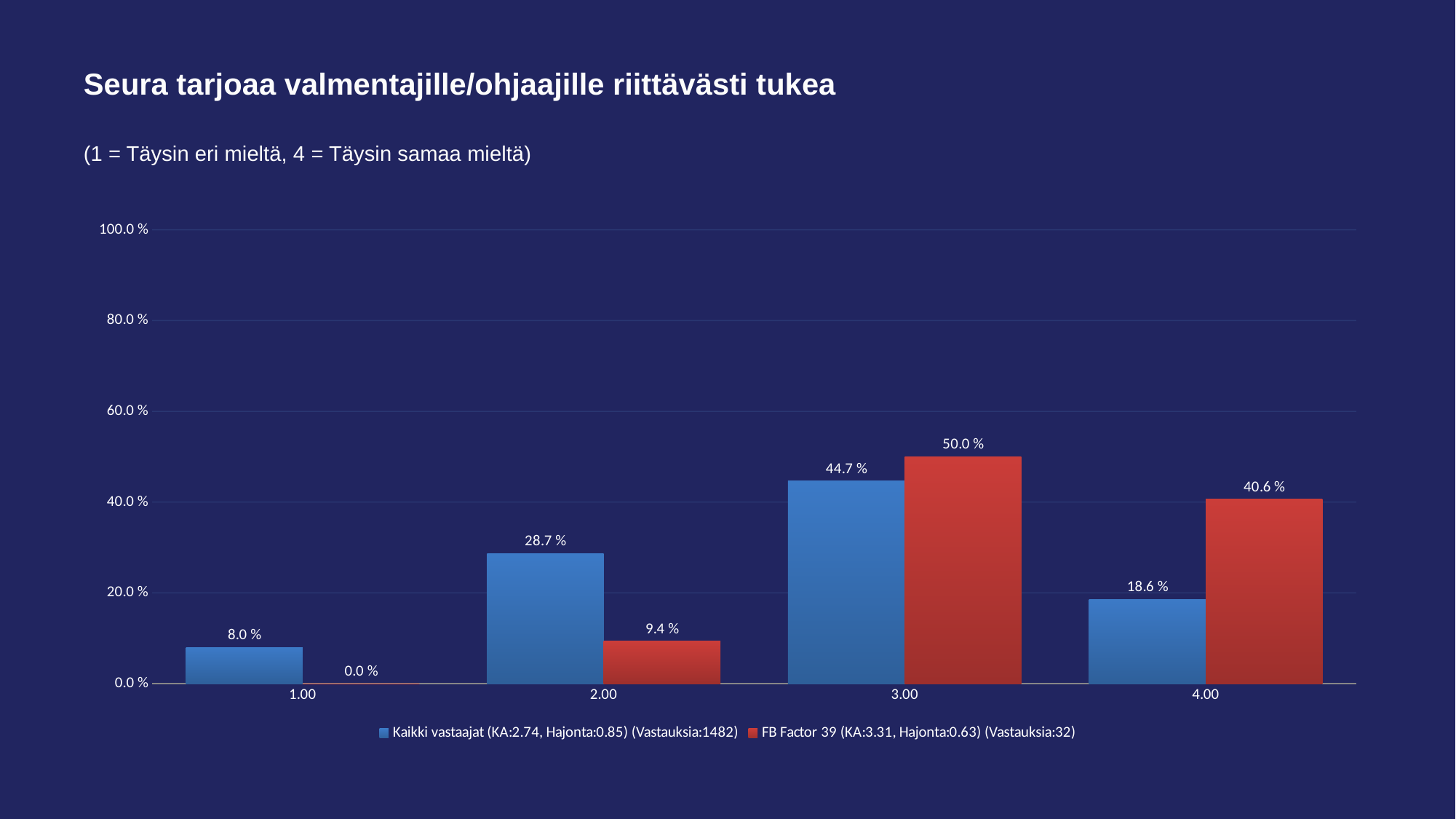
Is the value for FB Factor 39 at 3.00 greater or less than 40.0 %? greater What is the value for FB Factor 39 at 1.00? 0.0 % What is the value for FB Factor 39 at 4.00? 40.6 % What is the value for Kaikki vastaajat at 3.00? 44.7 % Which category has the lowest value for Kaikki vastaajat? 1.00 Which category has the highest value for FB Factor 39? 3.00 Which is larger at 2.00: Kaikki vastaajat or FB Factor 39? Kaikki vastaajat What is the value for Kaikki vastaajat at 2.00? 28.7 % How many series does the legend list? 2 What is the difference between the FB Factor 39 and Kaikki vastaajat values at 4.00? 22.0 % How many categories are shown on the x axis? 4 What kind of chart is shown on the slide? Bar chart